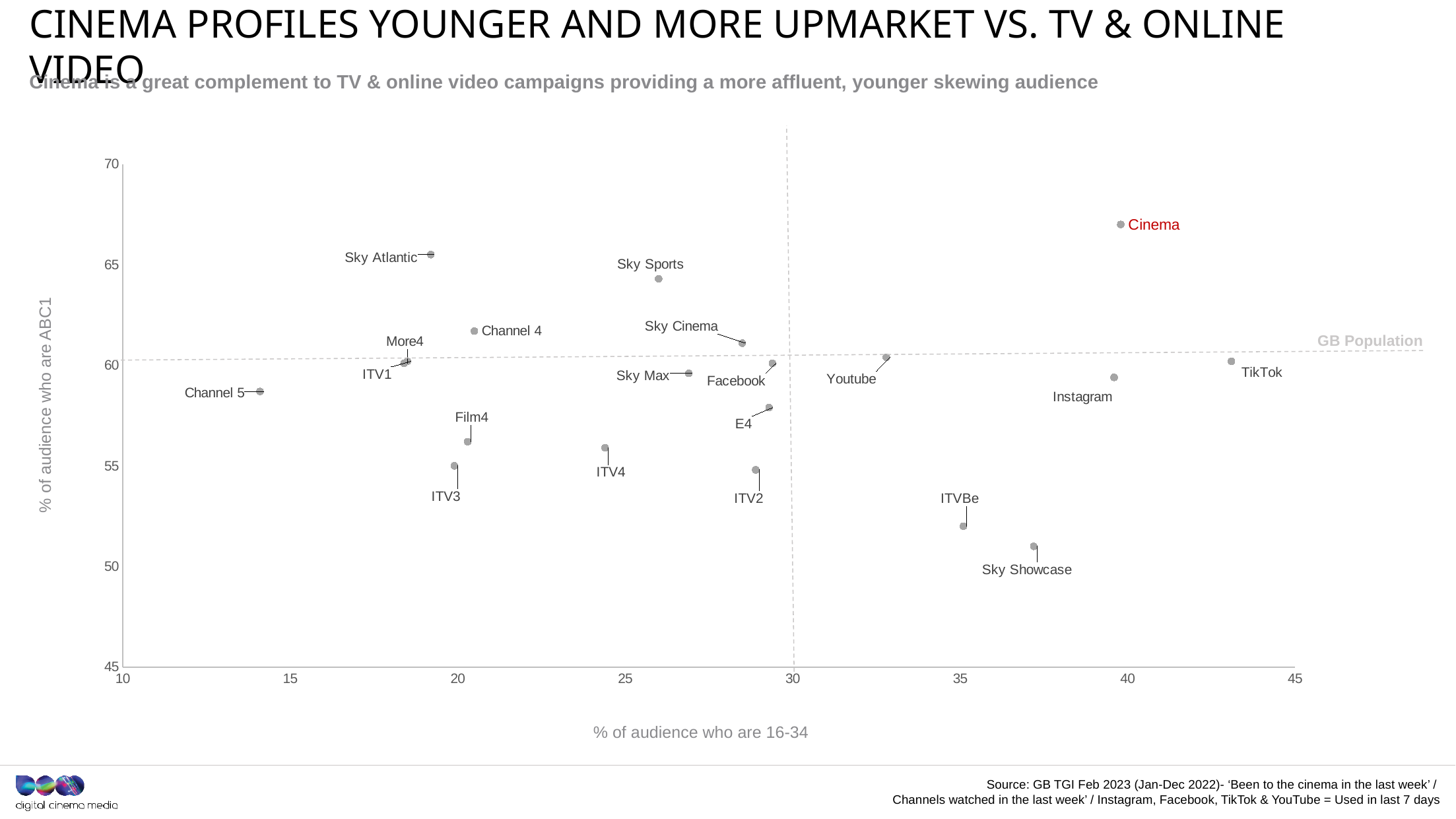
What kind of chart is shown on the slide? Scatter chart Is the % of audience who are 16-34 for Youtube greater or less than 30? greater Which has a higher % of audience who are ABC1, Sky Sports or Cinema? Cinema Which point has the highest % of audience who are 16-34? TikTok Which point has the lowest % of audience who are 16-34? Channel 5 Is the % of audience who are 16-34 for TikTok greater or less than 40? greater How many labelled points are plotted on the chart? 20 Which point has the highest % of audience who are ABC1? Cinema What is the label on the horizontal dashed reference line? GB Population Is the % of audience who are ABC1 for ITVBe greater or less than 55? less Which point has the lowest % of audience who are ABC1? Sky Showcase